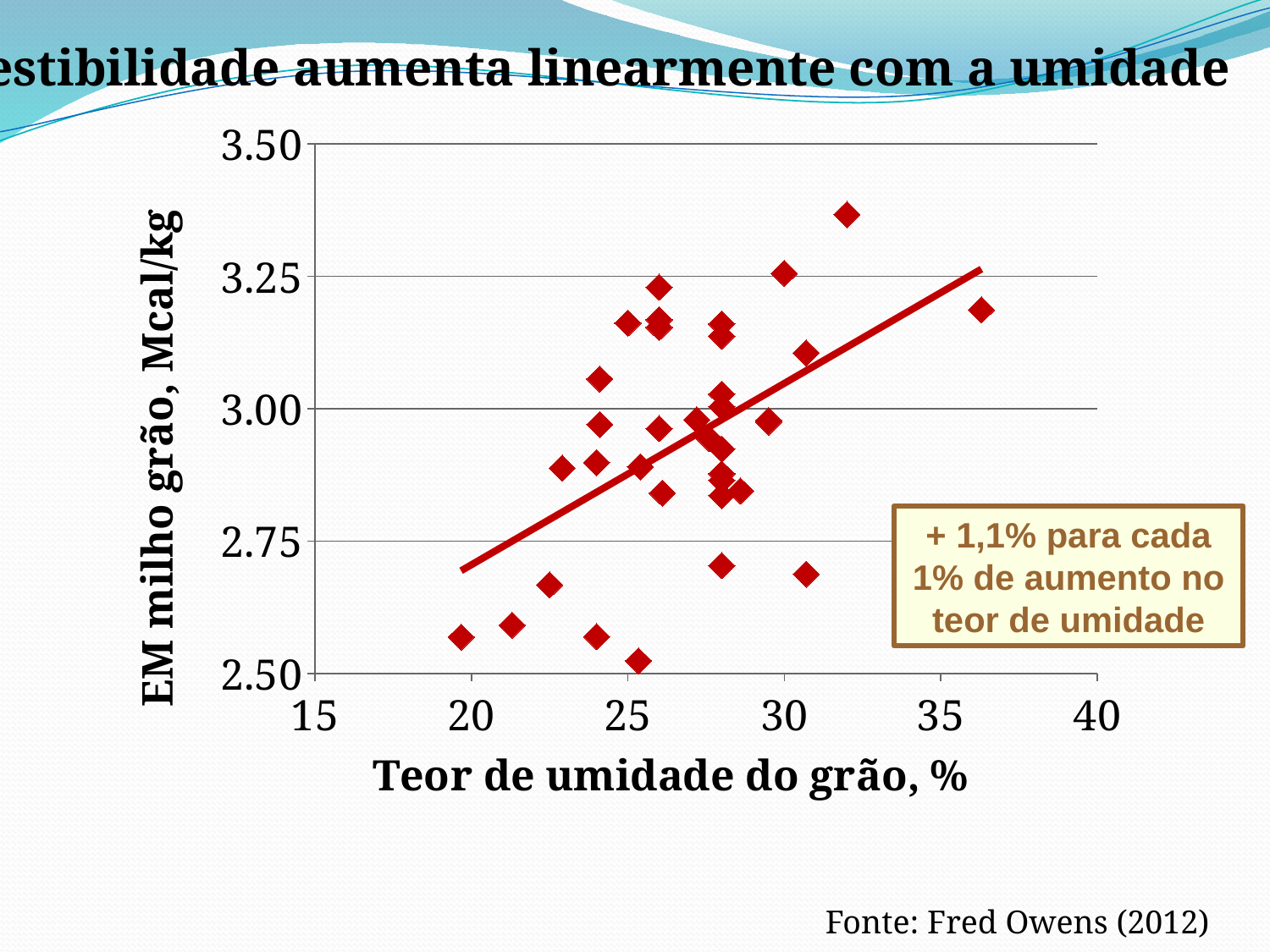
According to the text box on the chart, by how much does the value increase for each 1% increase in moisture content? + 1,1% Is the lowest plotted point on the chart greater or less than 2.75 Mcal/kg? less Is the highest plotted point on the chart greater or less than 3.25 Mcal/kg? greater What is the minimum value shown on the x axis of the chart? 15 Is the lowest plotted point on the chart located at a moisture content greater or less than 30%? less What kind of chart is shown on the slide? Scatter plot Who is cited as the source of the chart data? Fred Owens (2012) What is the title of the x axis of the chart? Teor de umidade do grão, % Do the values of EM milho grão rise or fall as the grain moisture content increases along the x axis? Rise